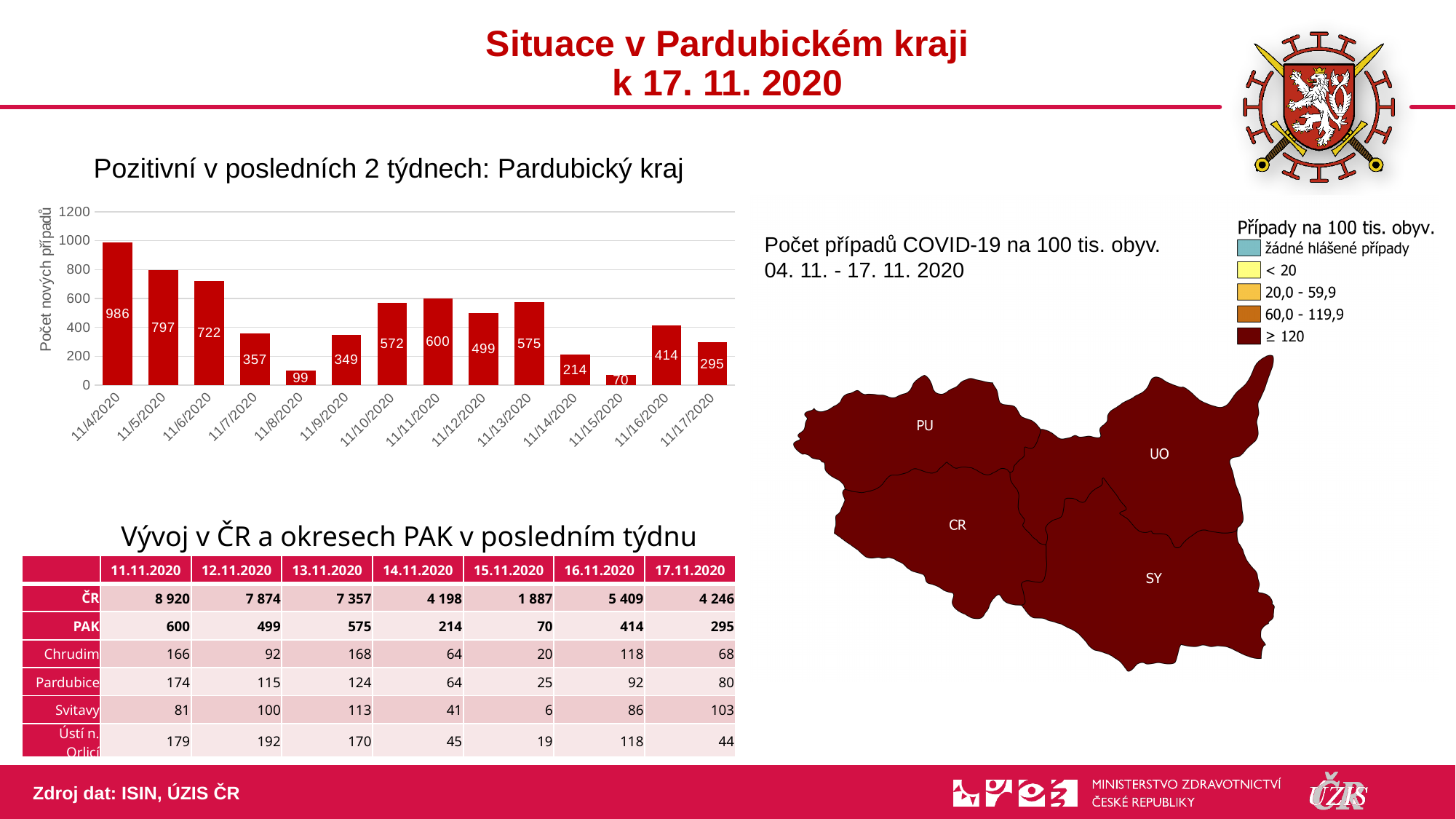
In the bar chart, what is the difference between the values for 11/4/2020 and 11/5/2020? 189 What is the label of the vertical axis of the bar chart? Počet nových případů How many dates (bars) are shown in the bar chart? 14 Which date has the highest value in the bar chart? 11/4/2020 Which date has the lowest value in the bar chart? 11/15/2020 In the bar chart, what is the value for 11/4/2020? 986 In the bar chart, what is the value for 11/16/2020? 414 What type of chart is shown under the title "Pozitivní v posledních 2 týdnech: Pardubický kraj"? bar chart In the bar chart, do the values rise or fall from 11/4/2020 to 11/8/2020? fall In the bar chart, which is larger: the value for 11/11/2020 or the value for 11/12/2020? 11/11/2020 In the bar chart, is the value for 11/6/2020 greater or less than 600? greater In the bar chart, what is the value for 11/8/2020? 99